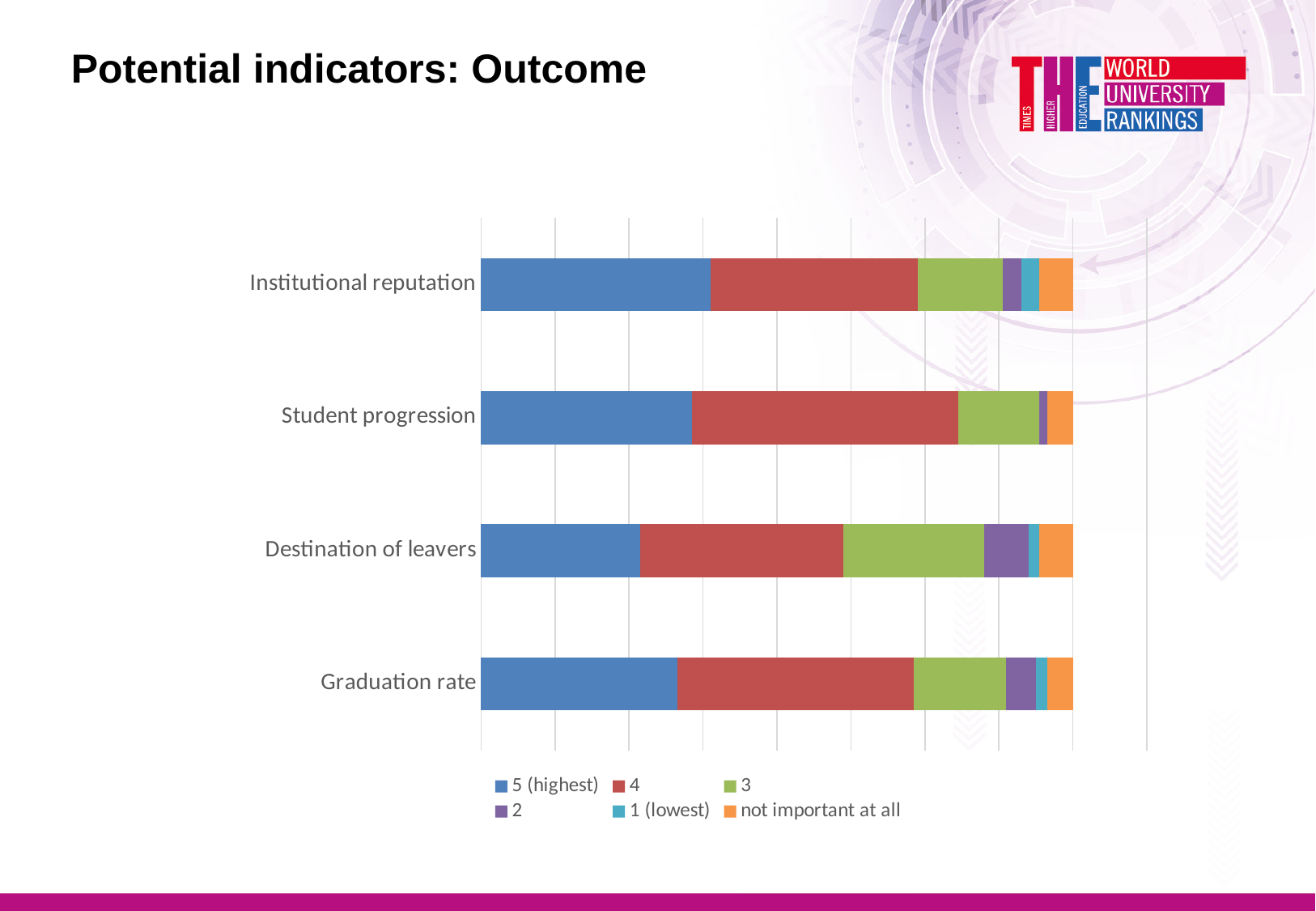
Is the '5 (highest)' segment larger for Graduation rate or for Destination of leavers? Graduation rate Which category has the largest '4' segment? Student progression Which category has the largest '2' segment? Destination of leavers Which category has the smallest '5 (highest)' segment? Destination of leavers How many categories (indicators) are plotted in the chart? 4 What kind of chart is shown on the slide? Stacked bar chart How many series does the legend list? 6 What is the title of the slide containing the chart? Potential indicators: Outcome Which category has the largest '3' segment? Destination of leavers Which legend entry is shown in orange? not important at all Is the '3' segment larger for Destination of leavers or for Student progression? Destination of leavers